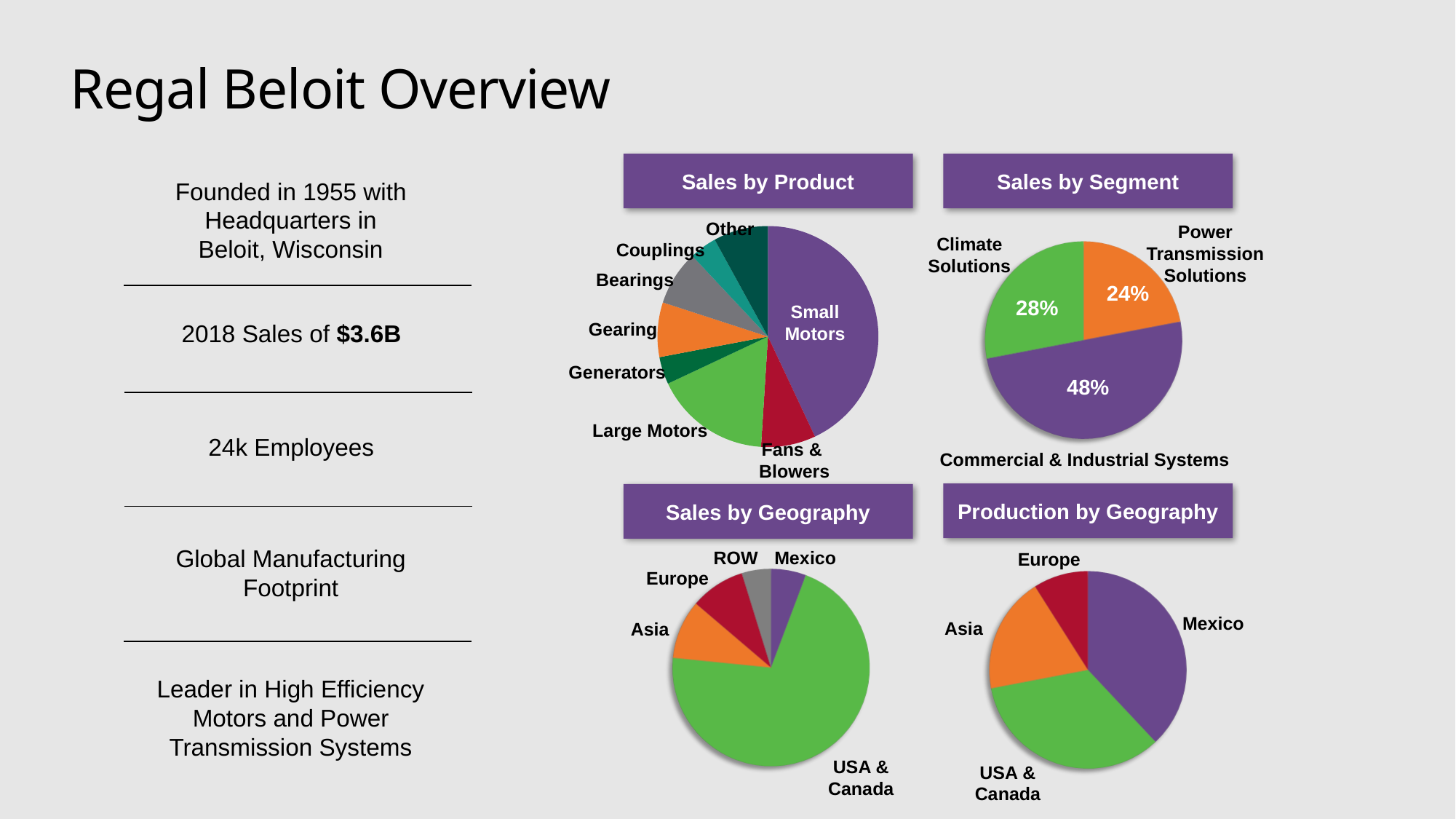
In the Production by Geography chart, which region has the smallest share? Europe In the Sales by Segment chart, which segment has the smallest share? Power Transmission Solutions What type of chart is the Sales by Geography chart? Pie chart In the Sales by Segment chart, what share of sales is Climate Solutions? 28% In the Sales by Segment chart, which segment has the largest share? Commercial & Industrial Systems In the Sales by Segment chart, what share of sales is Power Transmission Solutions? 24% In the Sales by Segment chart, how many percentage points larger is Commercial & Industrial Systems than Power Transmission Solutions? 24 In the Sales by Geography chart, which region has the largest share of sales? USA & Canada In the Sales by Product chart, which product has the largest share of sales? Small Motors How many product categories are shown in the Sales by Product chart? 8 In the Production by Geography chart, which is larger, Asia or Europe? Asia In the Sales by Segment chart, what share of sales is Commercial & Industrial Systems? 48%